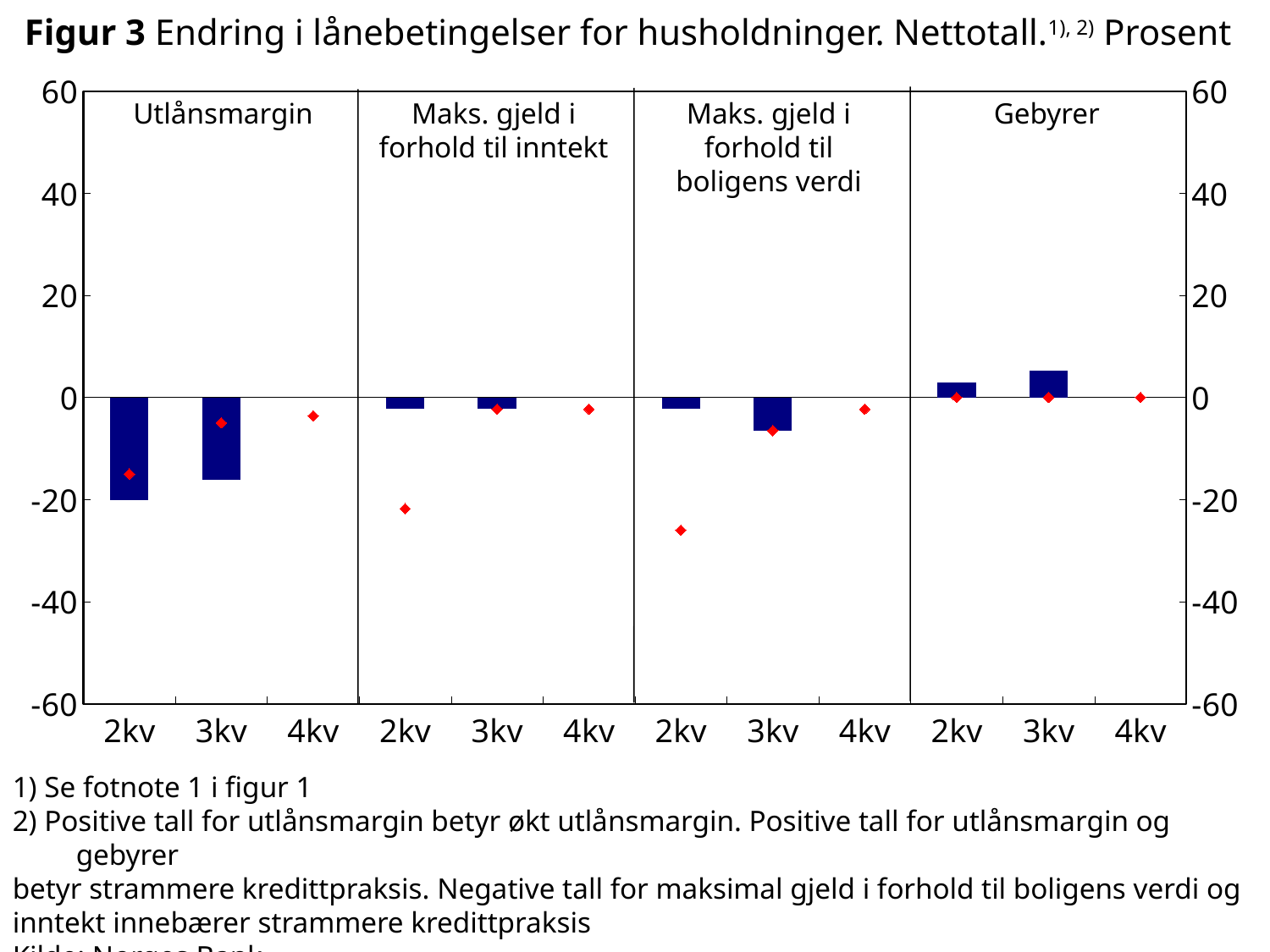
In the Utlånsmargin panel, which bar is lower, 2kv or 3kv? 2kv Which panel contains the lowest bar in the chart? Utlånsmargin What is the maximum value shown on the y axis? 60 In the Gebyrer panel, which bar is larger, 2kv or 3kv? 3kv How many quarter categories are shown on the x axis in total across all panels? 12 In the Utlånsmargin panel, is the bar for 2kv greater or less than -40? greater What is the title of the chart? Figur 3 Endring i lånebetingelser for husholdninger. Nettotall. Prosent In the Gebyrer panel, is the bar for 3kv greater or less than 0? greater What kind of chart is shown on the slide? bar chart Which panel contains the highest bar in the chart? Gebyrer In the Utlånsmargin panel, is the bar for 2kv greater or less than 0? less How many panels (loan condition categories) does the chart have? 4